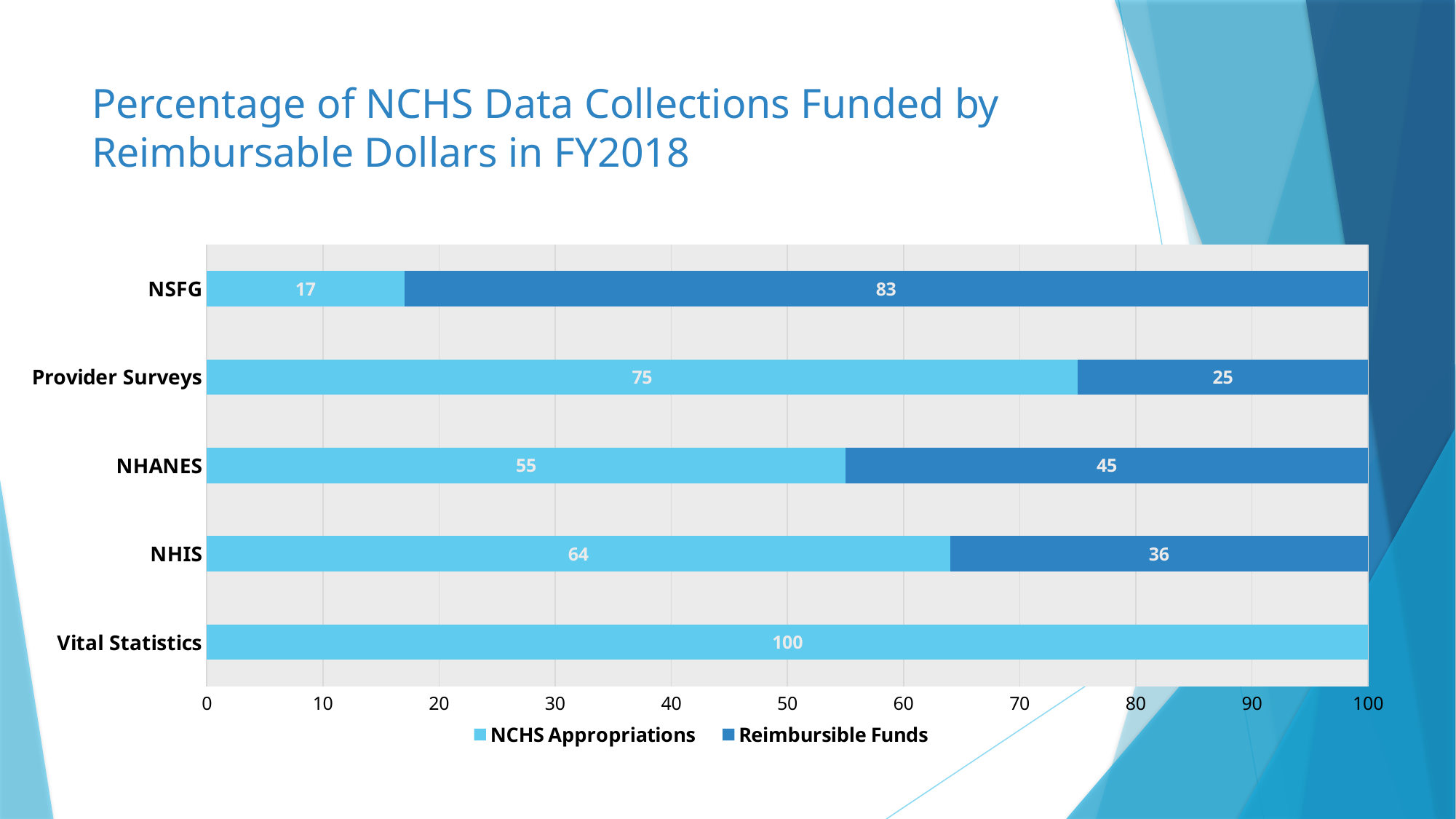
What kind of chart is shown on the slide? Stacked bar chart How many series does the legend list? 2 What is the title of the chart? Percentage of NCHS Data Collections Funded by Reimbursable Dollars in FY2018 Which is larger, the NCHS Appropriations value for NHIS or for NHANES? NHIS What is the total of the stacked bar for NHIS? 100 What is the Reimbursible Funds value for NHANES? 45 Which data collection has the lowest NCHS Appropriations value? NSFG What is the NCHS Appropriations value for NSFG? 17 How many data collections are shown on the chart? 5 What is the difference between the Reimbursible Funds values for NHIS and Provider Surveys? 11 What is the NCHS Appropriations value for Provider Surveys? 75 Which data collection has the highest Reimbursible Funds value? NSFG